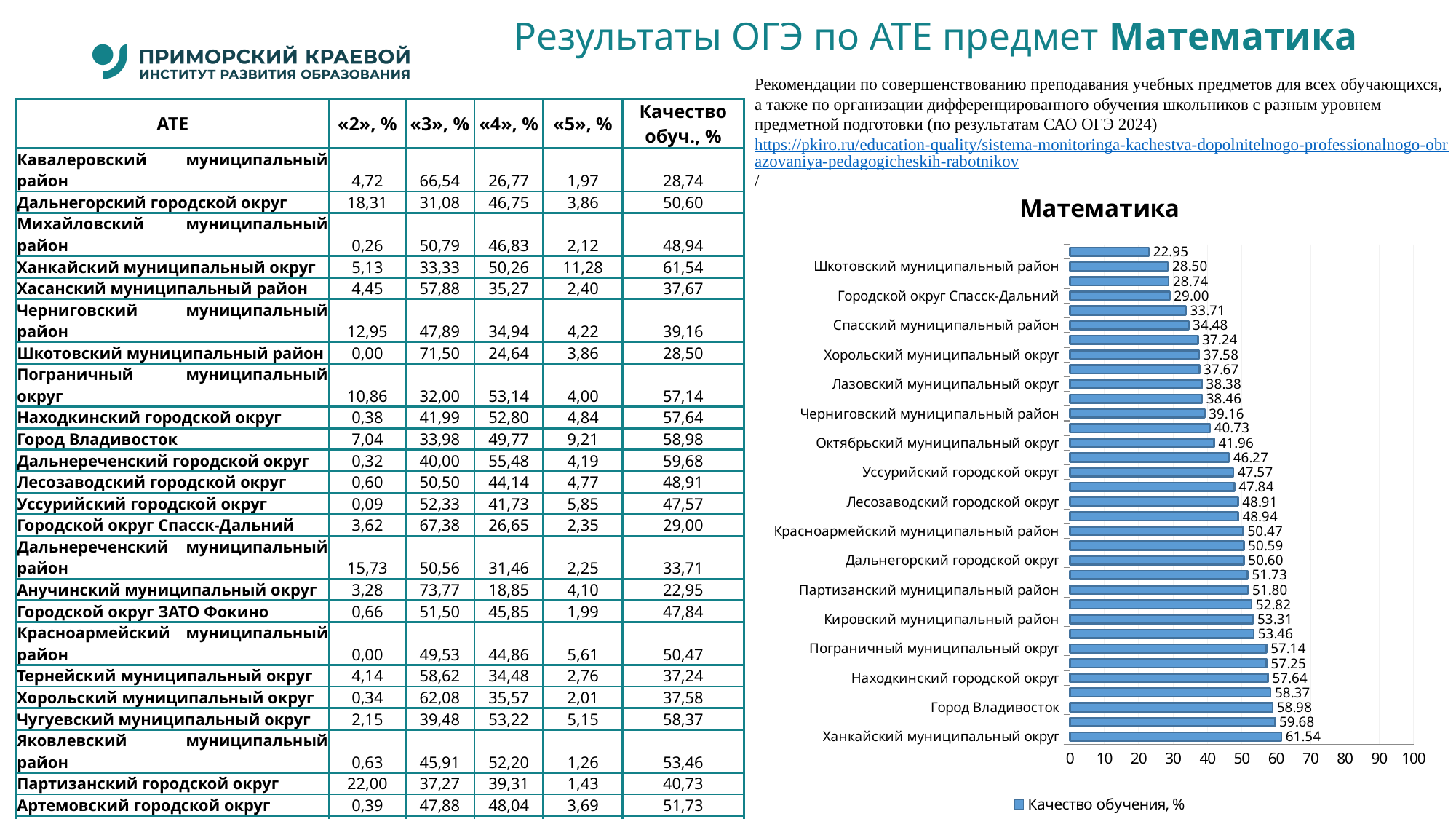
How many series does the legend of the "Математика" chart list? 1 In the "Математика" chart, what is the value for Город Владивосток? 58.98 In the "Математика" chart, which labeled category has the highest value? Ханкайский муниципальный округ What type of chart is shown under the title "Математика"? bar chart In the "Математика" chart, is the value for Черниговский муниципальный район greater or less than 40? less In the "Математика" chart, what is the value for Шкотовский муниципальный район? 28.50 What is the legend entry of the "Математика" chart? Качество обучения, % In the "Математика" chart, what is the value for Уссурийский городской округ? 47.57 In the "Математика" chart, what is the value for Ханкайский муниципальный округ? 61.54 How many bars are plotted in the "Математика" chart? 34 In the "Математика" chart, what is the difference between the values for Находкинский городской округ and Пограничный муниципальный округ? 0.50 In the "Математика" chart, which is larger: the value for Дальнегорский городской округ or the value for Красноармейский муниципальный район? Дальнегорский городской округ